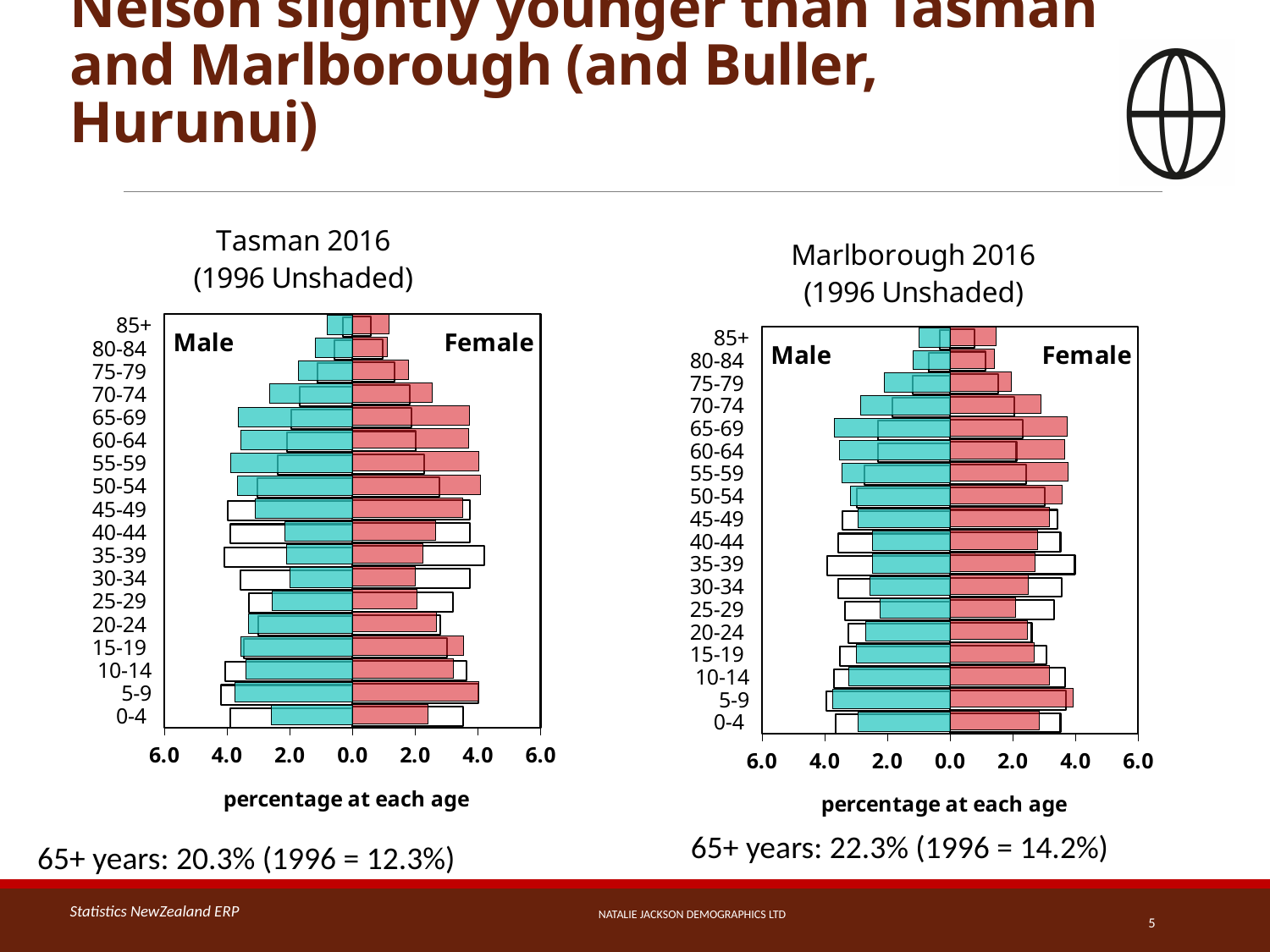
On the Marlborough 2016 chart, is the 2016 female value for the 5-9 age group greater or less than 2.0? greater Which region had the higher 65+ share in 2016, Tasman or Marlborough? Marlborough According to the text under the Marlborough 2016 chart, what percentage of Marlborough's population was aged 65+ in 1996? 14.2% On the Marlborough 2016 chart, is the 2016 female value for the 85+ age group greater or less than 2.0? less On the Tasman 2016 chart, is the 2016 female value for the 65-69 age group greater or less than 2.0? greater On the Marlborough 2016 chart, which side of the pyramid shows females? Right side What is the x-axis label on the Tasman 2016 chart? percentage at each age What kind of chart is the Tasman 2016 chart? Bar chart How many age groups are shown on the Marlborough 2016 chart? 18 According to the text under the Tasman 2016 chart, what percentage of Tasman's population was aged 65+ in 2016? 20.3% On the Tasman 2016 chart, which age group has the smallest 2016 male bar? 85+